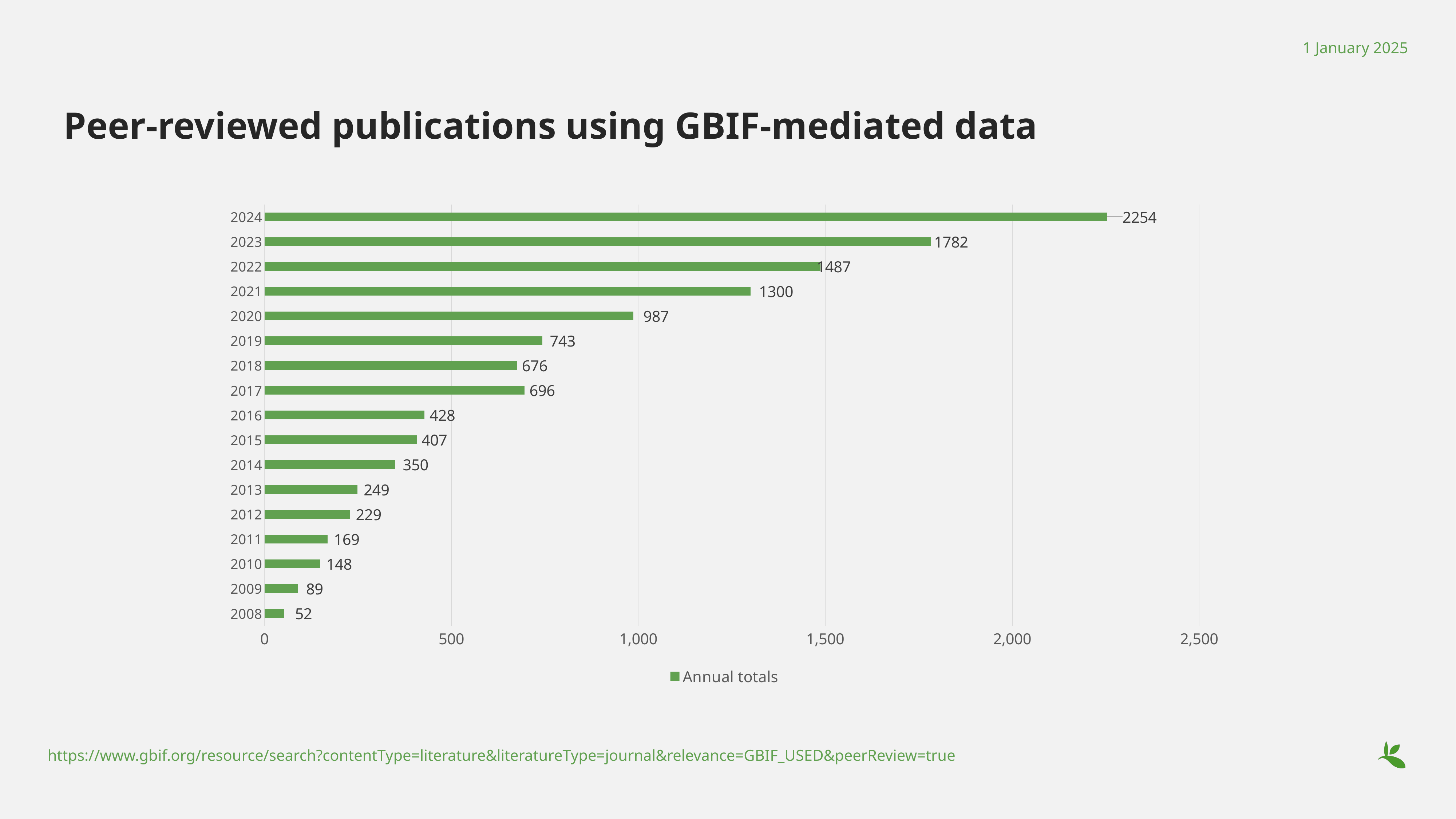
How many series does the legend list? 1 What is the difference between the values for 2024 and 2023? 472 What is the value for 2017? 696 Which year has the lowest value? 2008 Which is larger, the value for 2018 or the value for 2017? 2017 What kind of chart is shown? bar chart Which year has the highest value? 2024 What is the legend entry for the series? Annual totals What is the value for 2008? 52 How many years are shown on the chart? 17 Is the value for 2020 greater or less than 1,000? less What is the value for 2024? 2254